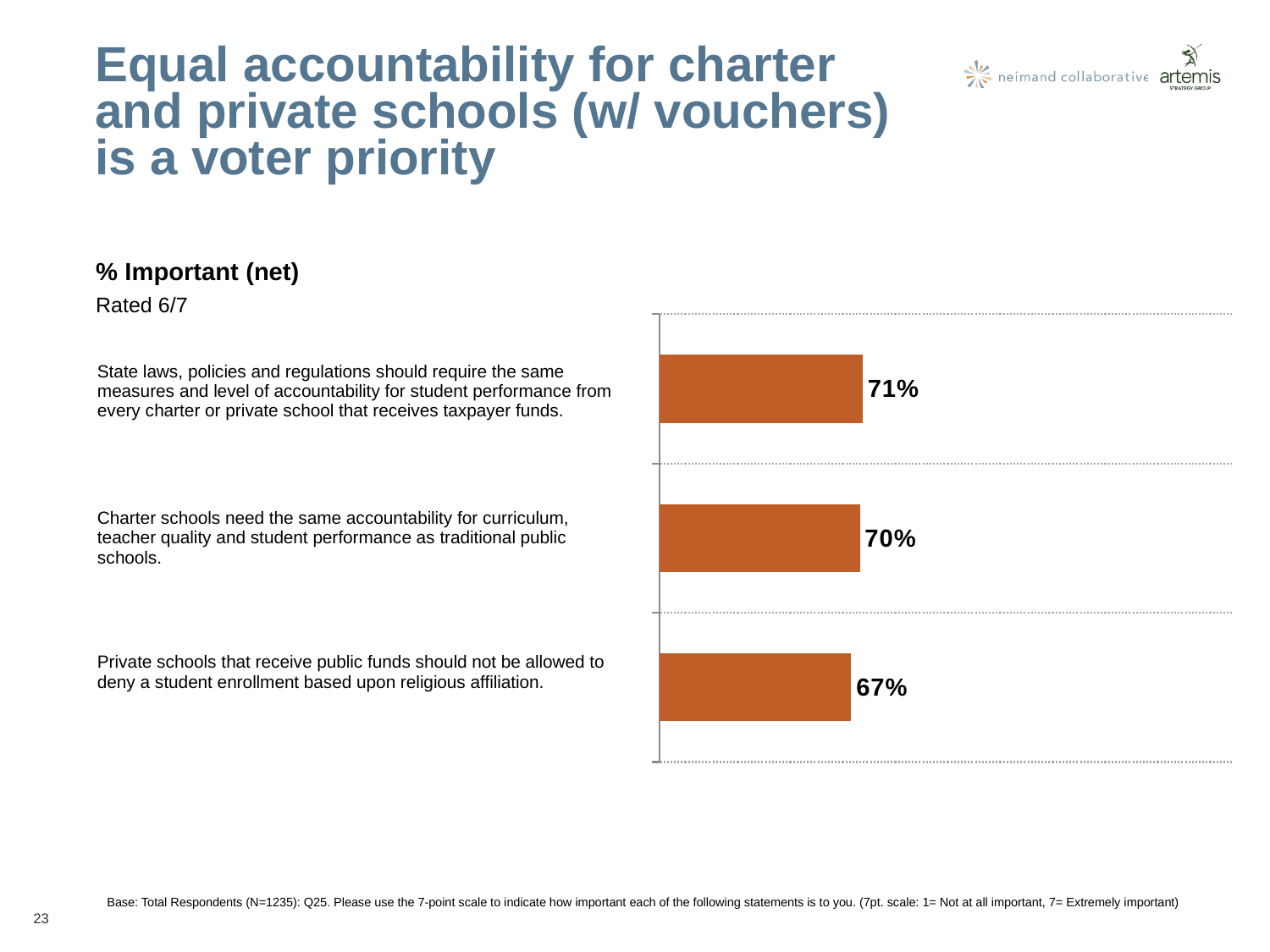
Do the % Important values increase or decrease from the top bar to the bottom bar? Decrease What colour are the bars in the chart? Orange Which statement has the lowest % Important (net)? Private schools that receive public funds should not be allowed to deny a student enrollment based upon religious affiliation. Which statement has the highest % Important (net)? State laws, policies and regulations should require the same measures and level of accountability for student performance from every charter or private school that receives taxpayer funds. What percentage of respondents rated the statement about state laws requiring the same accountability for every charter or private school receiving taxpayer funds as important? 71% What is the difference in percentage points between the highest and lowest % Important values shown? 4 How many statements are plotted in the chart? 3 What rating range on the 7-point scale is counted as 'Important (net)' in this chart? Rated 6/7 What is the difference between the % Important for the charter school accountability statement and the private school religious affiliation statement? 3 What percentage rated the statement that private schools receiving public funds should not deny enrollment based on religious affiliation as important? 67% What percentage rated the statement that charter schools need the same accountability as traditional public schools as important? 70% What type of chart is shown on the slide? Bar chart